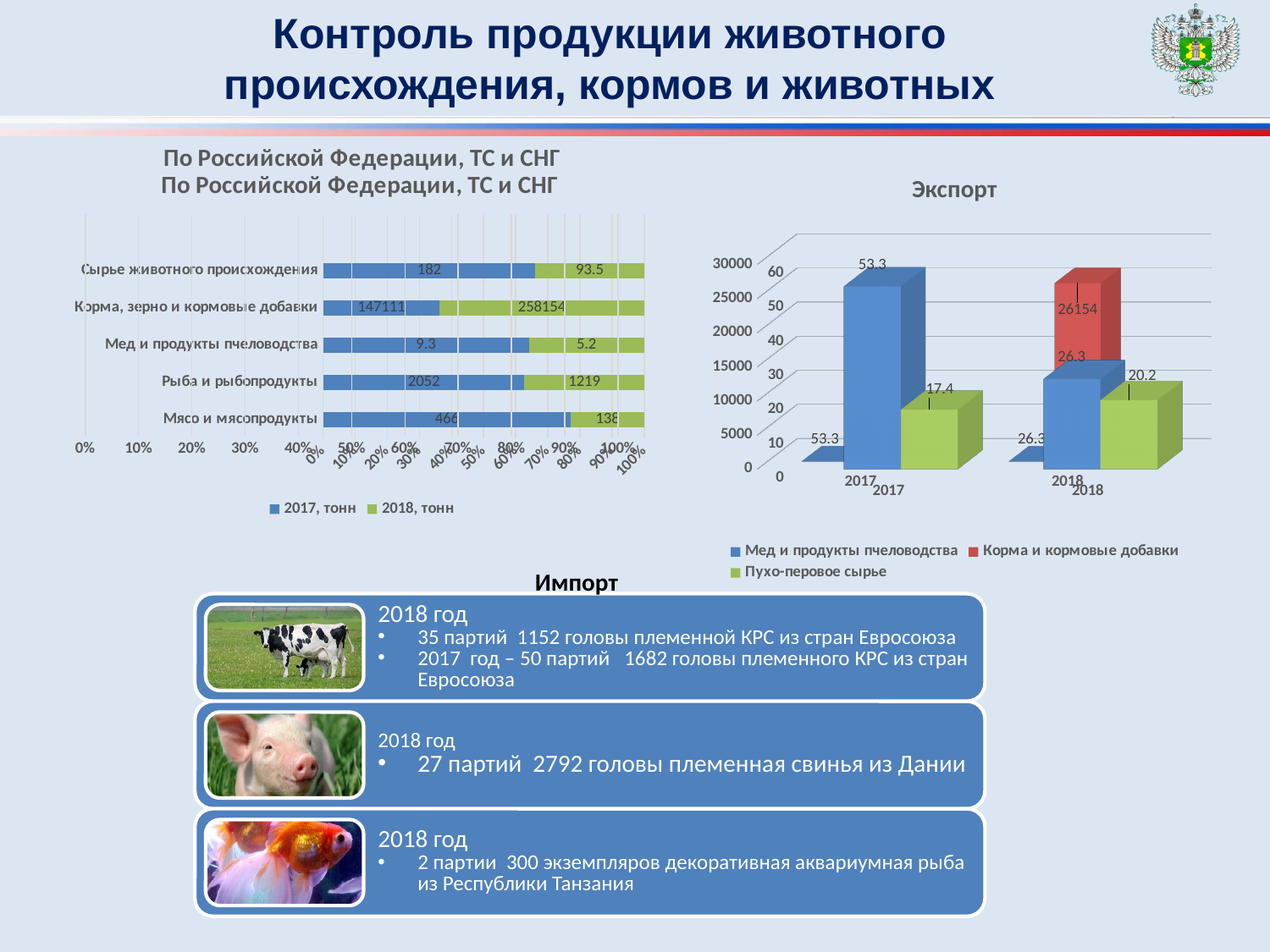
How many categories are shown in the chart 'По Российской Федерации, ТС и СНГ'? 5 What type of chart is 'По Российской Федерации, ТС и СНГ'? Stacked bar chart In the chart 'По Российской Федерации, ТС и СНГ', which is larger for 'Сырье животного происхождения': the 2017 value or the 2018 value? 2017 In the chart 'По Российской Федерации, ТС и СНГ', what is the 2018 value for 'Корма, зерно и кормовые добавки'? 258154 How many series does the legend of the chart 'По Российской Федерации, ТС и СНГ' list? 2 In the chart 'По Российской Федерации, ТС и СНГ', what is the 2017 value for 'Рыба и рыбопродукты'? 2052 In the 'Экспорт' chart, what is the value labelled for 'Пухо-перовое сырье' in 2018? 20.2 In the chart 'По Российской Федерации, ТС и СНГ', what is the difference between the 2017 and 2018 values for 'Рыба и рыбопродукты'? 833 In the chart 'По Российской Федерации, ТС и СНГ', what is the 2018 value for 'Мед и продукты пчеловодства'? 5.2 In the 'Экспорт' chart, what is the value labelled for 'Мед и продукты пчеловодства' in 2017? 53.3 How many series does the legend of the 'Экспорт' chart list? 3 In the chart 'По Российской Федерации, ТС и СНГ', what is the 2017 value for 'Мясо и мясопродукты'? 466